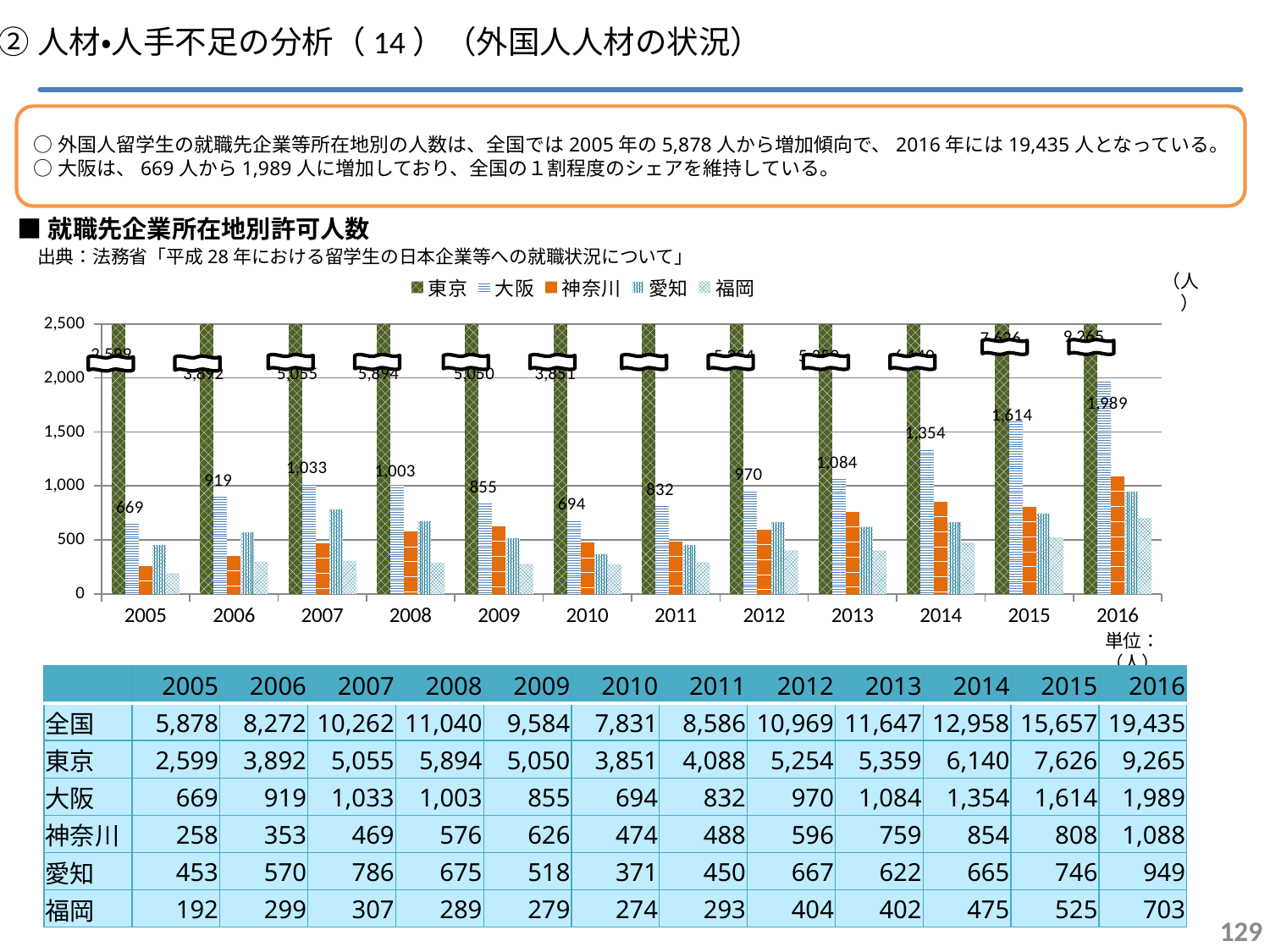
What is the value for 大阪 in 2016 on the chart? 1,989 How many series does the chart legend list? 5 In which year is the 大阪 value lowest on the chart? 2005 What is the difference between the 大阪 values for 2016 and 2005? 1,320 How many years are shown along the x axis of the chart? 12 Which is larger on the chart, the 大阪 value for 2007 or for 2008? 2007 Is the value for 大阪 in 2014 greater or less than 1,000? greater In which year is the 大阪 value highest on the chart? 2016 What is the value for 大阪 in 2005 on the chart? 669 What kind of chart is shown on the slide? bar chart Which series in the chart is drawn in orange? 神奈川 What is the value for 大阪 in 2010 on the chart? 694